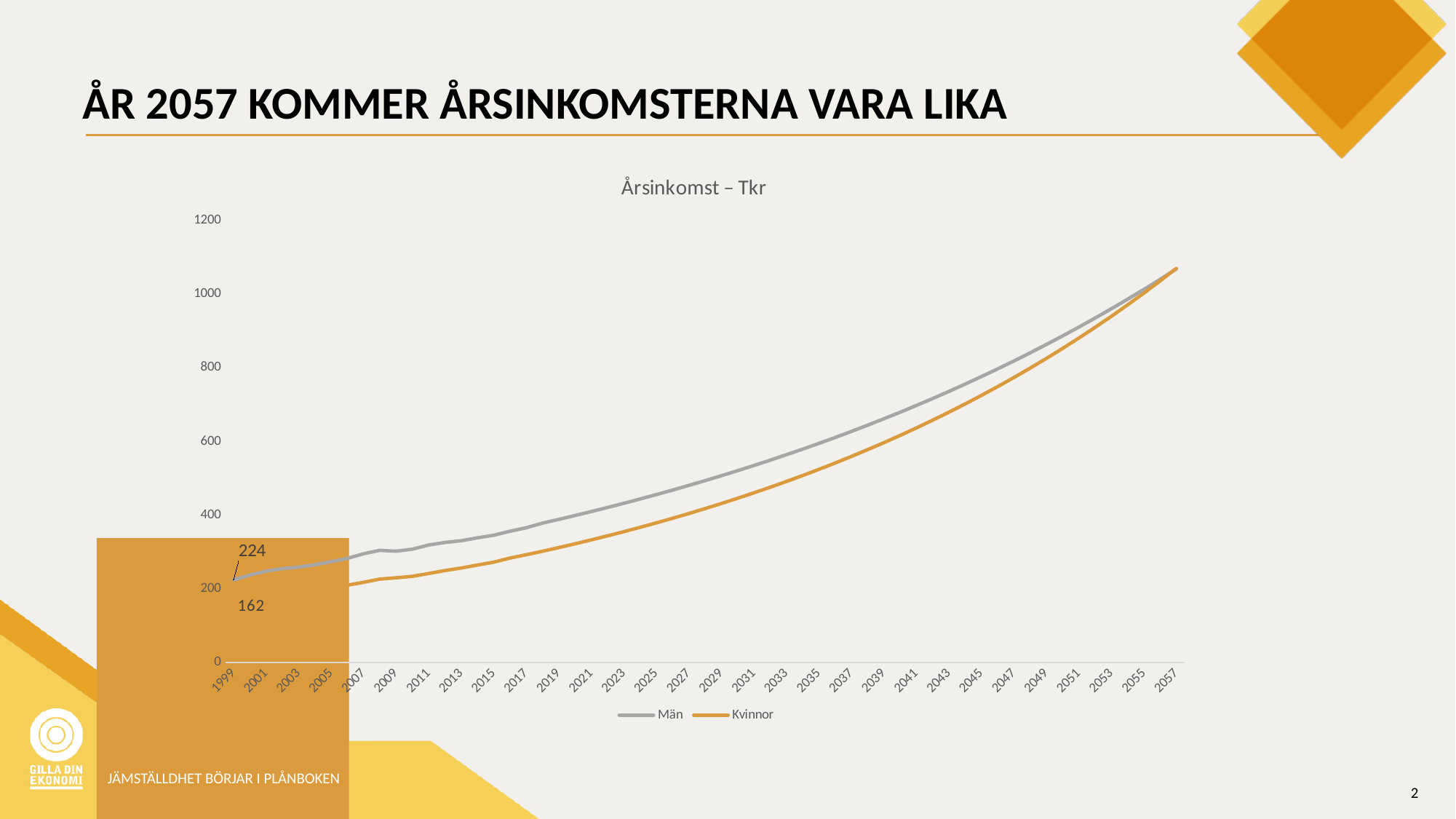
What is the value for Män in 1999? 224 Do the values for Kvinnor rise or fall from 1999 to 2057? rise What is the value for Kvinnor in 1999? 162 What is the title of the chart? Årsinkomst – Tkr In 2031, which series has the higher value, Män or Kvinnor? Män How many series does the legend of the chart list? 2 Is the value for Män in 2057 greater or less than 1000? greater What are the two series named in the chart legend? Män and Kvinnor Is the value for Kvinnor in 2031 greater or less than 600? less What kind of chart is shown on the slide? line chart What is the difference between the Män and Kvinnor values in 1999? 62 Is the value for Män in 2041 greater or less than 600? greater